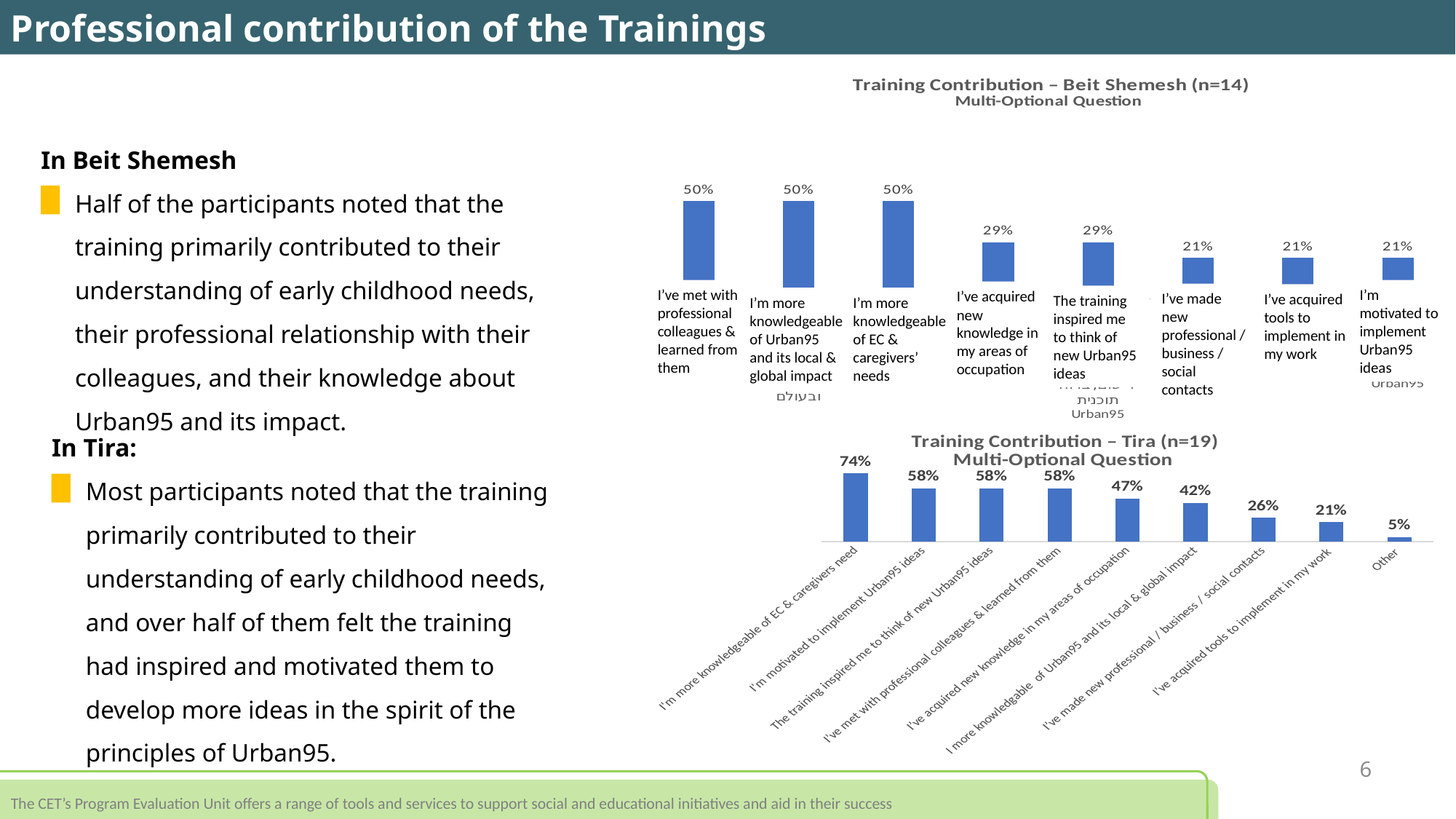
In the Training Contribution – Beit Shemesh (n=14) chart, what is the value for "I've acquired tools to implement in my work"? 21% In the Training Contribution – Tira (n=19) chart, which category has the lowest value? Other In the Training Contribution – Tira (n=19) chart, what is the difference between "I'm more knowledgeable of EC & caregivers need" and "I've acquired tools to implement in my work"? 53% In the Training Contribution – Tira (n=19) chart, which is larger: "I've acquired new knowledge in my areas of occupation" or "I've made new professional / business / social contacts"? I've acquired new knowledge in my areas of occupation In the Training Contribution – Beit Shemesh (n=14) chart, what is the difference between "I've met with professional colleagues & learned from them" and "I've made new professional / business / social contacts"? 29% How many categories are shown in the Training Contribution – Beit Shemesh (n=14) chart? 8 How many categories are shown in the Training Contribution – Tira (n=19) chart? 9 In the Training Contribution – Tira (n=19) chart, what is the value for "Other"? 5% In the Training Contribution – Tira (n=19) chart, which category has the highest value? I'm more knowledgeable of EC & caregivers need In the Training Contribution – Beit Shemesh (n=14) chart, what is the value for "I've acquired new knowledge in my areas of occupation"? 29% What type of chart is the Training Contribution – Beit Shemesh (n=14) chart? Bar chart In the Training Contribution – Tira (n=19) chart, what is the value for "I'm more knowledgeable of EC & caregivers need"? 74%